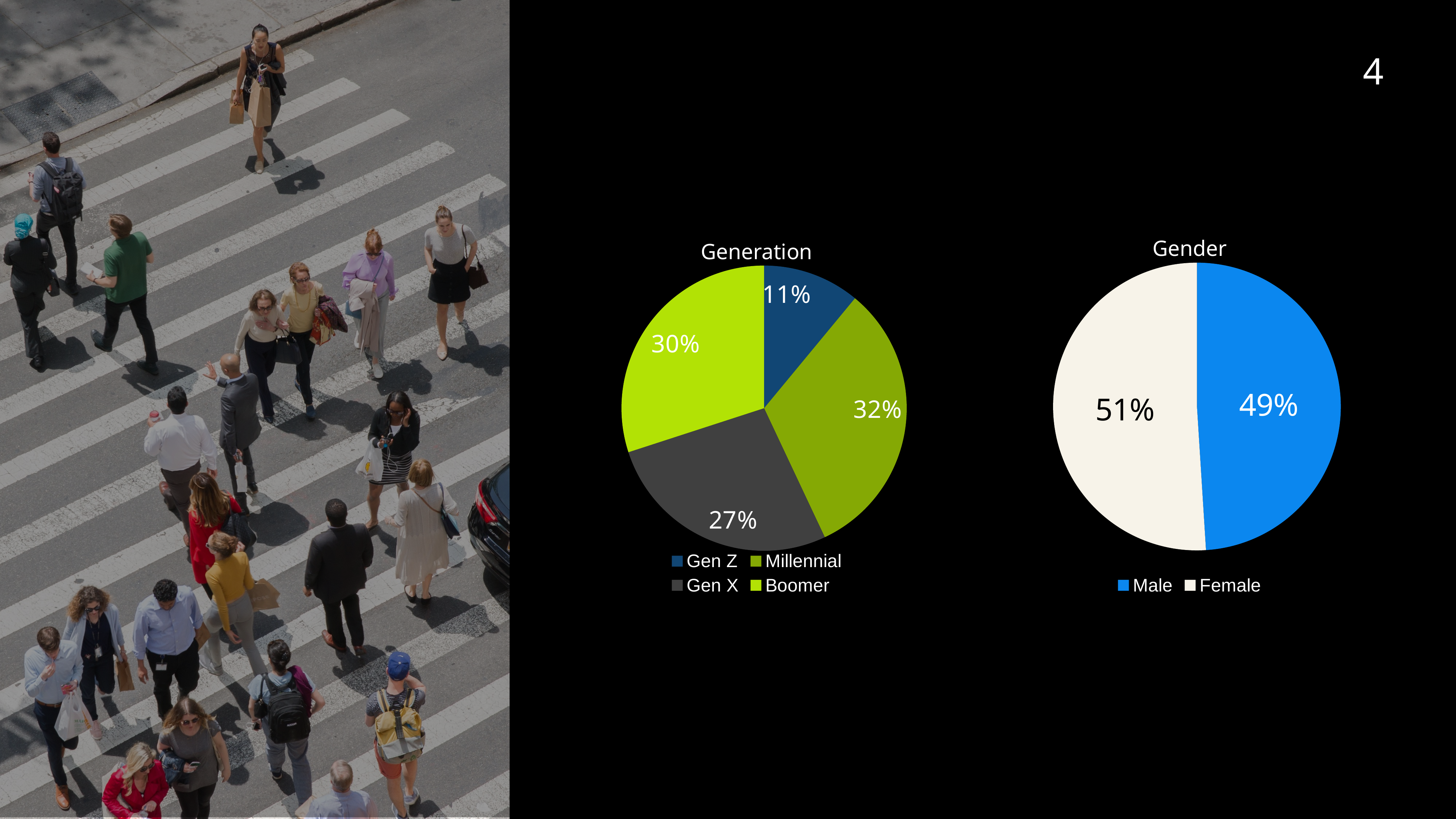
In the Generation chart, which generation has the smallest share? Gen Z In the Generation chart, what share is Millennial? 32% In the Generation chart, what share is Gen X? 27% In the Gender chart, what colour is the Male slice? Blue In the Generation chart, what share is Boomer? 30% In the Generation chart, which generation has the largest share? Millennial In the Generation chart, what share is Gen Z? 11% In the Generation chart, how many slices does the pie have? 4 In the Gender chart, what share is Female? 51% In the Generation chart, what is the difference between the Millennial and Gen Z shares? 21% What kind of chart is the Gender chart? Pie chart In the Gender chart, what share is Male? 49%